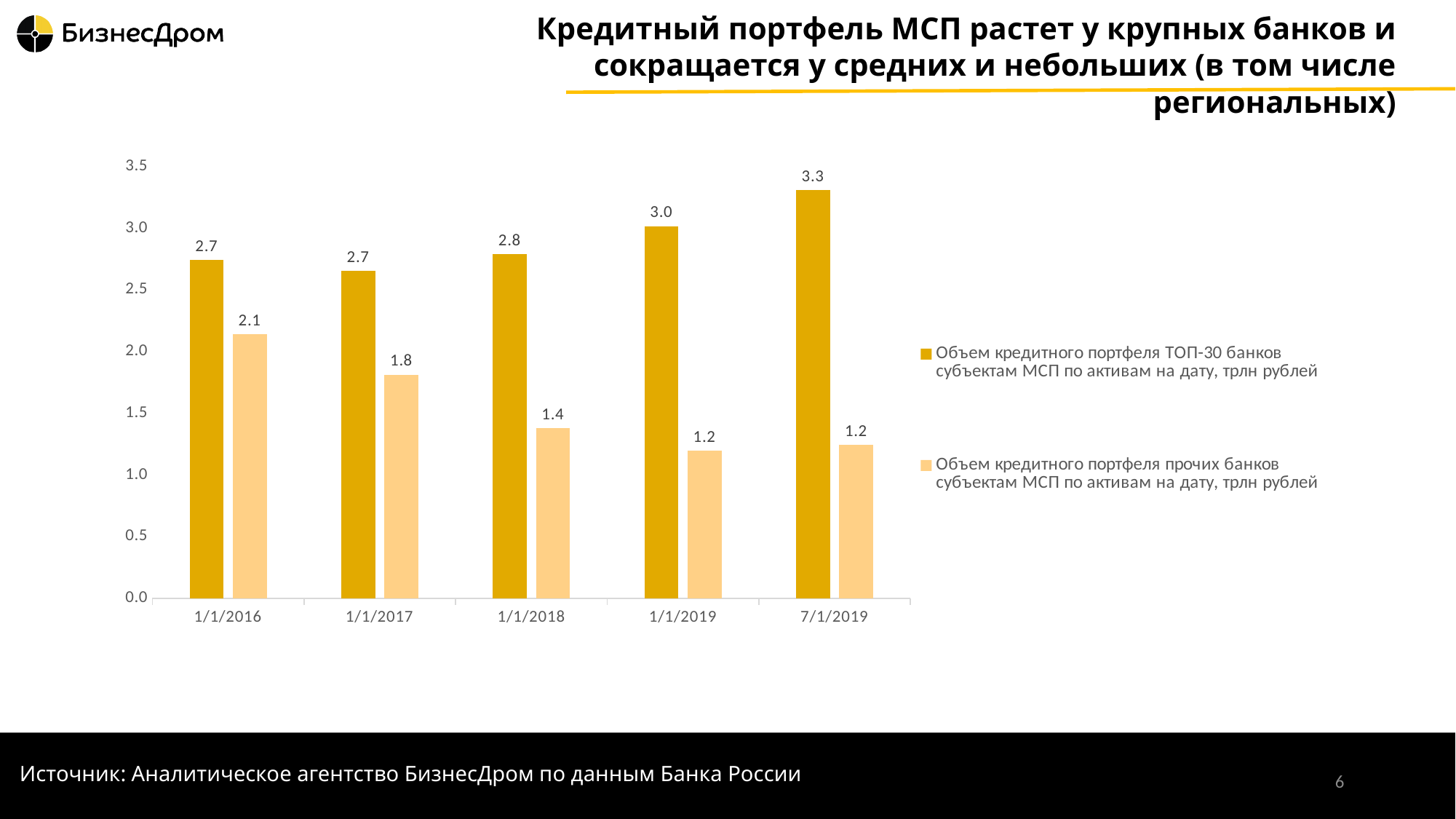
At which date is the TOP-30 banks series highest? 7/1/2019 What is the value for the other banks series (Объем кредитного портфеля прочих банков) at 1/1/2016? 2.1 At which date is the other banks series highest? 1/1/2016 What unit is stated in the legend for the plotted values? трлн рублей What is the difference between the TOP-30 banks value and the other banks value at 1/1/2019? 1.8 What is the value for the other banks series at 1/1/2018? 1.4 Does the other banks series rise or fall from 1/1/2016 to 1/1/2019? Fall What kind of chart is shown on the slide? Bar chart How many series does the legend list? 2 What is the value for the TOP-30 banks series (Объем кредитного портфеля ТОП-30 банков) at 7/1/2019? 3.3 How many dates are shown on the x axis? 5 Which is larger at 1/1/2017: the TOP-30 banks value or the other banks value? TOP-30 banks (2.7)